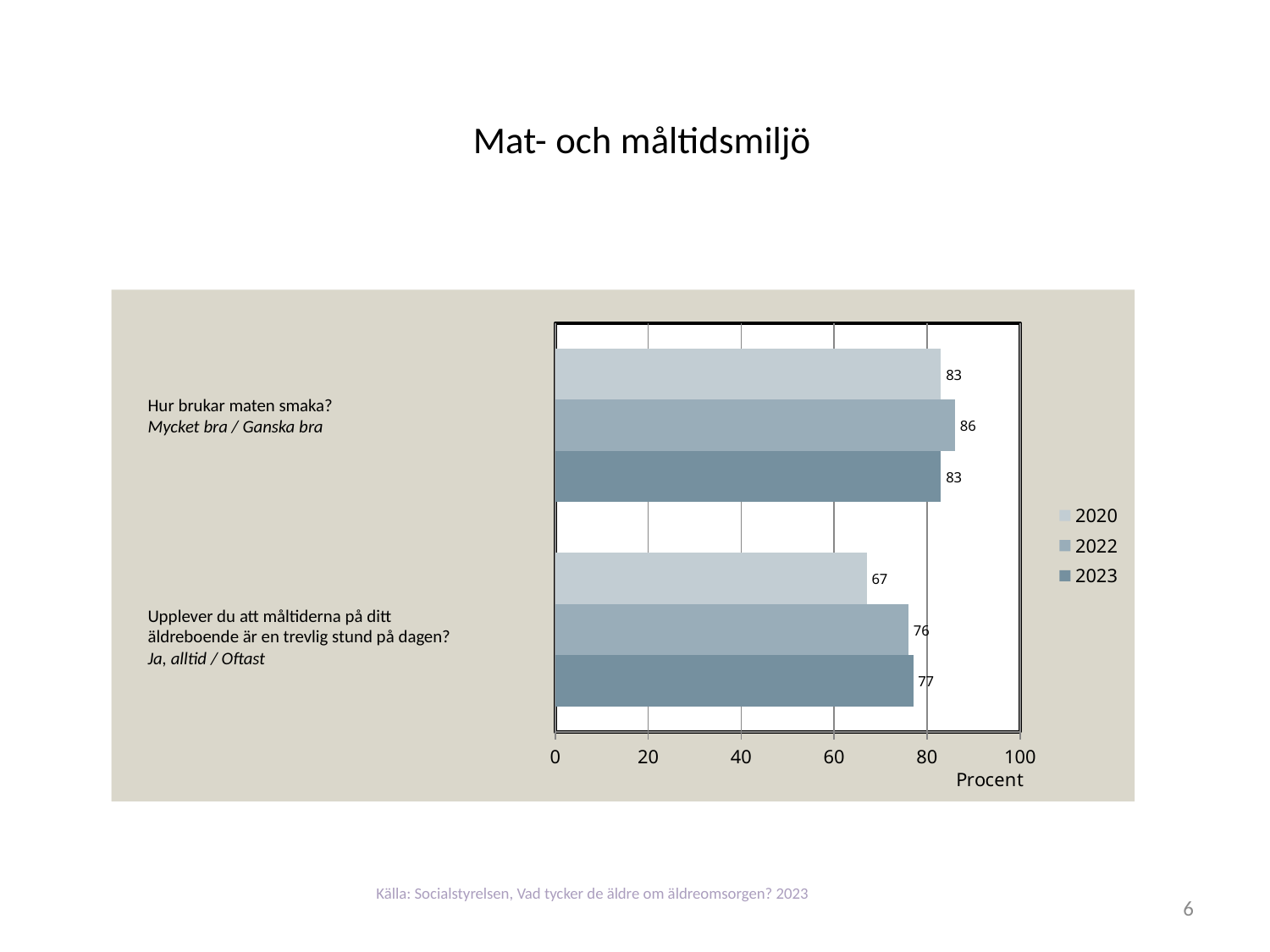
What is the 2020 value for "Upplever du att måltiderna på ditt äldreboende är en trevlig stund på dagen?"? 67 What is the 2022 value for "Hur brukar maten smaka?"? 86 Which year has the lowest value for "Upplever du att måltiderna på ditt äldreboende är en trevlig stund på dagen?"? 2020 What is the 2023 value for "Upplever du att måltiderna på ditt äldreboende är en trevlig stund på dagen?"? 77 What is the label on the horizontal axis of the chart? Procent How many question categories are shown in the chart? 2 How many series does the legend list? 3 What is the 2023 value for "Hur brukar maten smaka?"? 83 What type of chart is shown on the slide? Bar chart Which year has the highest value for "Hur brukar maten smaka?"? 2022 Which is larger: the 2020 value for "Hur brukar maten smaka?" or the 2020 value for "Upplever du att måltiderna på ditt äldreboende är en trevlig stund på dagen?"? Hur brukar maten smaka? What is the difference between the 2022 and 2020 values for "Upplever du att måltiderna på ditt äldreboende är en trevlig stund på dagen?"? 9